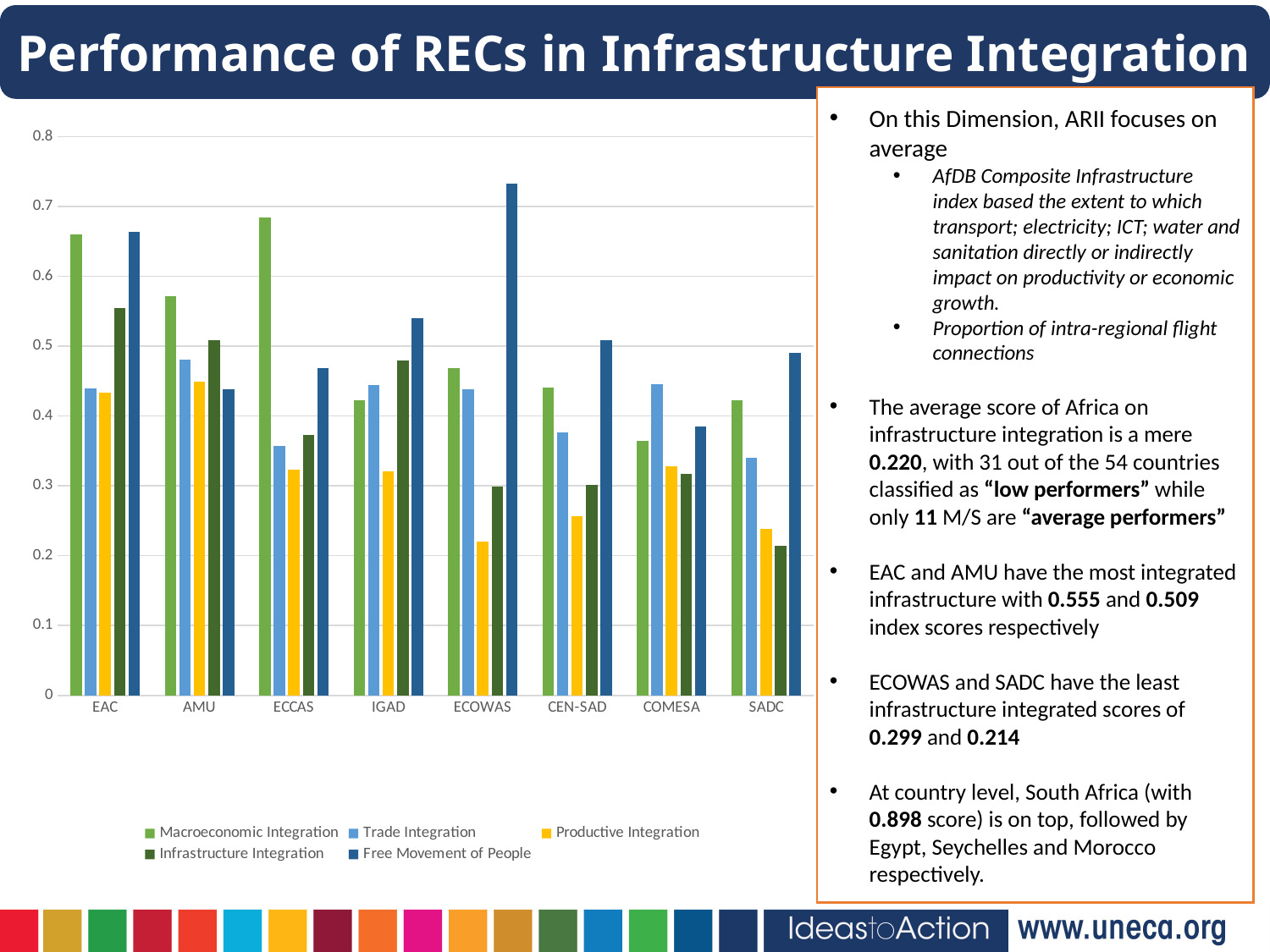
Is the Macroeconomic Integration value for ECCAS greater or less than 0.6? greater How many regional economic communities (categories) are shown on the x axis of the chart? 8 Is the Free Movement of People value for ECOWAS greater or less than 0.7? greater How many series does the chart's legend list? 5 For EAC, which is larger: the Macroeconomic Integration value or the Trade Integration value? Macroeconomic Integration Which category has the highest Free Movement of People value? ECOWAS What colour represents Productive Integration in the chart's legend? yellow Which category has the highest Infrastructure Integration value? EAC Which category has the highest Macroeconomic Integration value? ECCAS What kind of chart is shown on the slide? bar chart Is the Infrastructure Integration value for SADC greater or less than 0.3? less Which category has the lowest Infrastructure Integration value? SADC